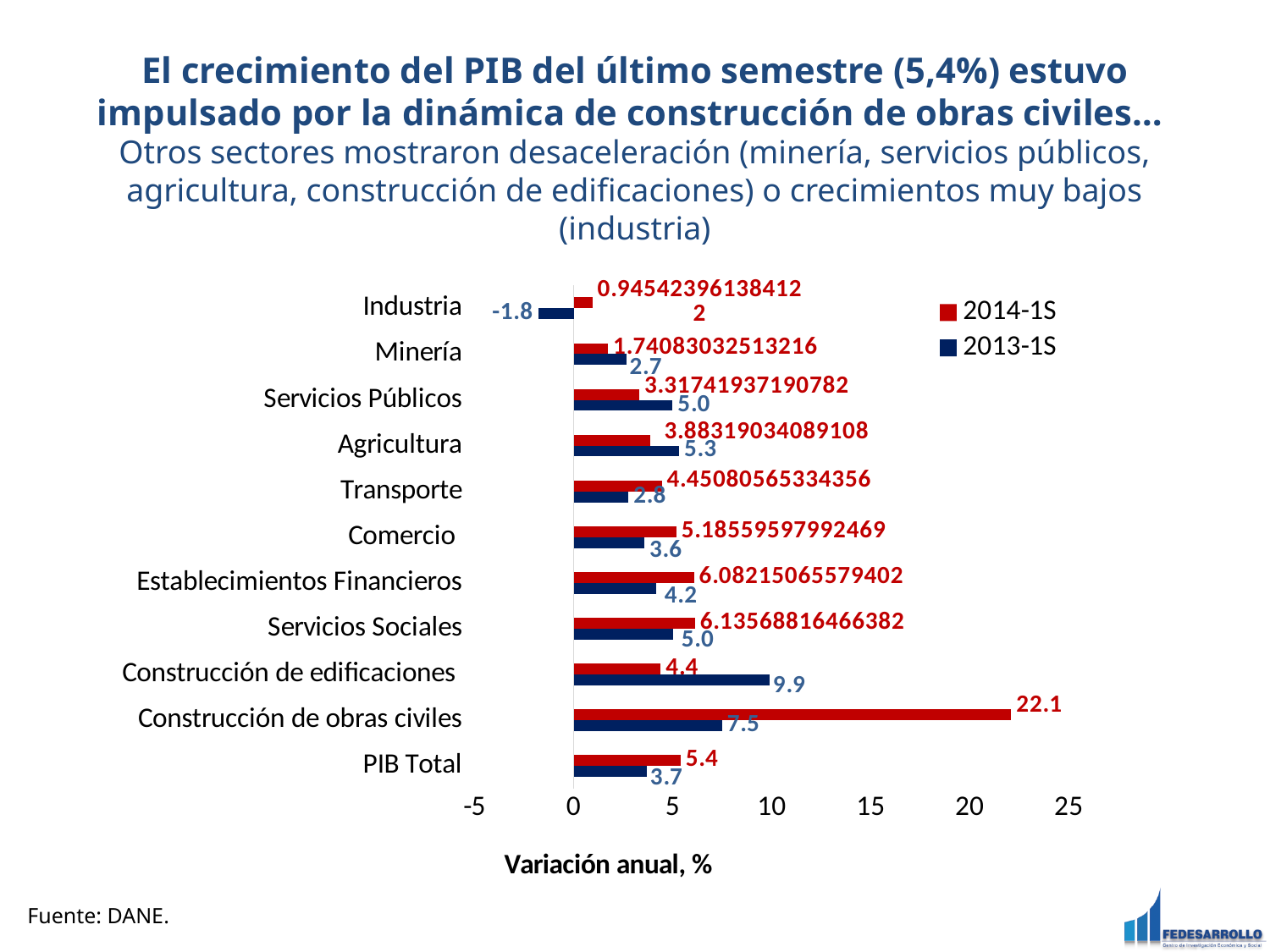
What is the 2013-1S value for Industria? -1.8 What is the difference between the 2014-1S and 2013-1S values for Construcción de obras civiles? 14.6 What is the 2013-1S value for Construcción de edificaciones? 9.9 What is the title of the horizontal axis? Variación anual, % Which category has the highest 2014-1S value? Construcción de obras civiles How many sector categories are plotted on the chart? 11 What is the 2014-1S value for PIB Total? 5.4 For Transporte, which series has the larger value, 2014-1S or 2013-1S? 2014-1S How many series does the legend list? 2 Which category has the lowest 2013-1S value? Industria What type of chart is shown on the slide? bar chart What is the 2014-1S value for Construcción de obras civiles? 22.1